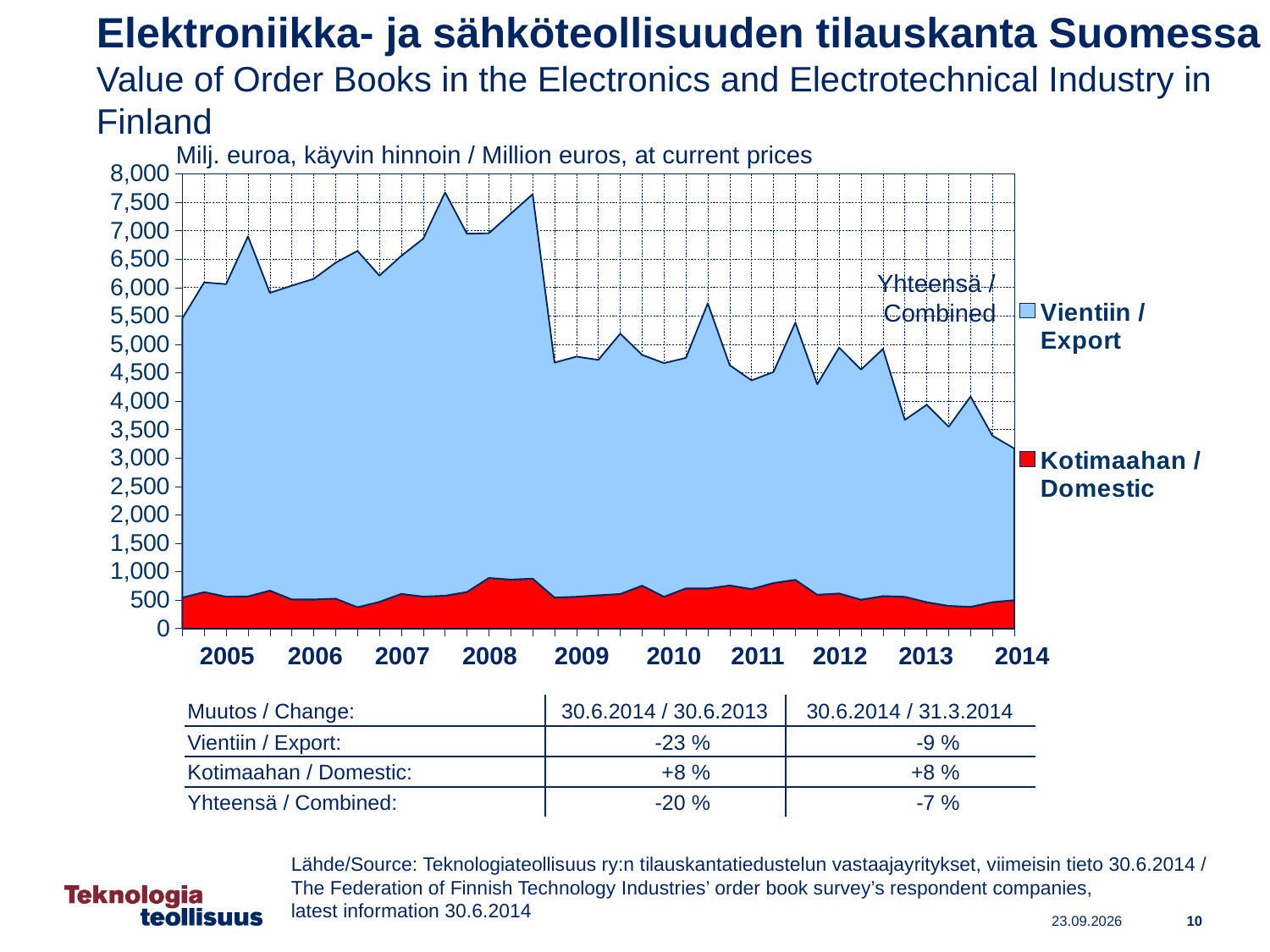
Is the highest combined (Yhteensä / Combined) value on the chart greater or less than 7,500? greater Which series is larger throughout the chart, Vientiin / Export or Kotimaahan / Domestic? Vientiin / Export What unit is stated above the chart for the values? Milj. euroa, käyvin hinnoin / Million euros, at current prices What kind of chart is shown on the slide? Area chart Does the combined order book value rise or fall between 2008 and 2014? Fall Is the combined (Yhteensä / Combined) value at the start of 2005 greater or less than 5,000? greater How many series does the chart legend list? 2 Is the combined (Yhteensä / Combined) value at the end of the chart in 2014 greater or less than 3,500? less How many year labels are shown on the x axis of the chart? 10 Which is larger, the combined value at the start of 2005 or the combined value at the end of 2014? 2005 What colour represents Kotimaahan / Domestic in the chart? Red